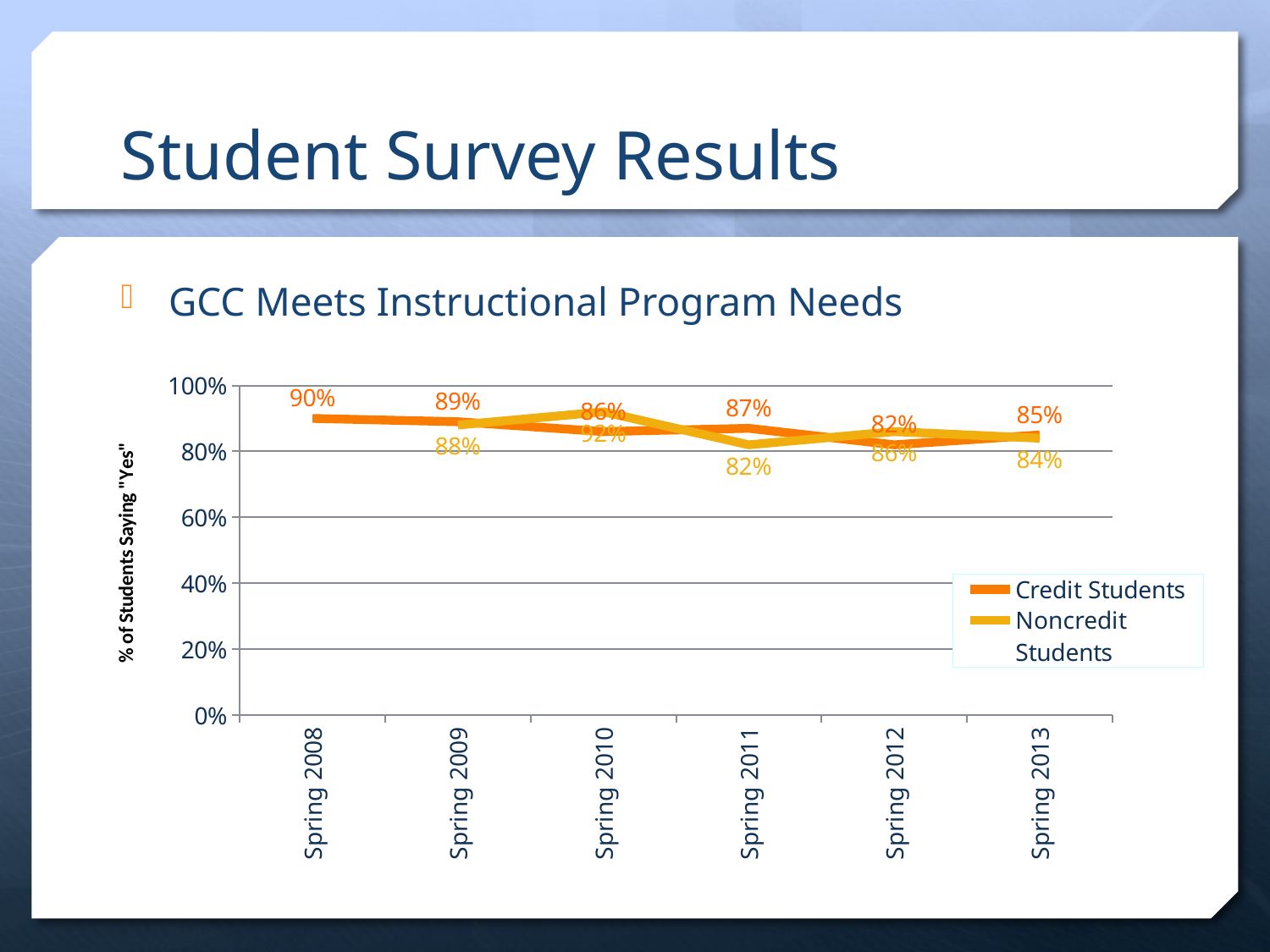
What kind of chart is shown on the slide? Line chart In which survey period was the Credit Students value highest? Spring 2008 What is the difference between the Credit Students values for Spring 2008 and Spring 2013? 5% How many survey periods are shown along the x axis? 6 In Spring 2011, which series had the higher value, Credit Students or Noncredit Students? Credit Students What percentage of Noncredit Students said "Yes" in Spring 2013? 84% What is the title of the y axis? % of Students Saying "Yes" In which survey period was the Credit Students value lowest? Spring 2012 What percentage of Credit Students said "Yes" in Spring 2013? 85% What percentage of Credit Students said "Yes" in Spring 2008? 90% What percentage of Noncredit Students said "Yes" in Spring 2011? 82% How many series does the legend list? 2